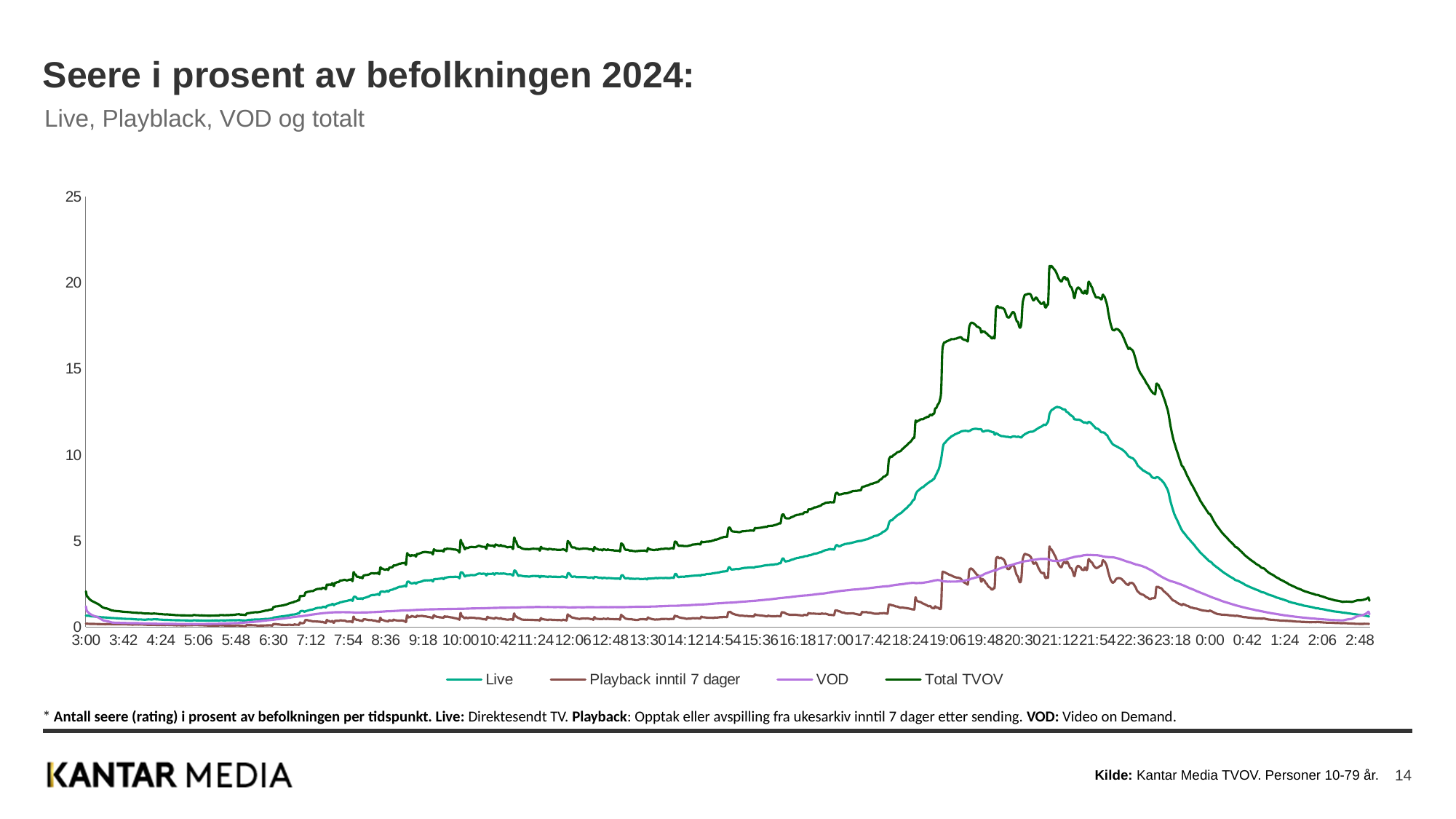
Does the Total TVOV line rise or fall between 16:18 and 21:12? rise What kind of chart is shown on the slide? line chart How many series does the legend list? 4 Is the peak value of VOD around 21:54 greater or less than 5? less At 22:36, which is larger, VOD or Playback inntil 7 dager? VOD Is the peak value of Live around 21:12 greater or less than 10? greater Which series reaches the highest value on the chart? Total TVOV What is the title of the chart slide? Seere i prosent av befolkningen 2024: Is the value for Total TVOV at 16:18 greater or less than 5? greater Which series has the lowest value at 3:00? Playback inntil 7 dager At 21:12, which is larger, Live or VOD? Live